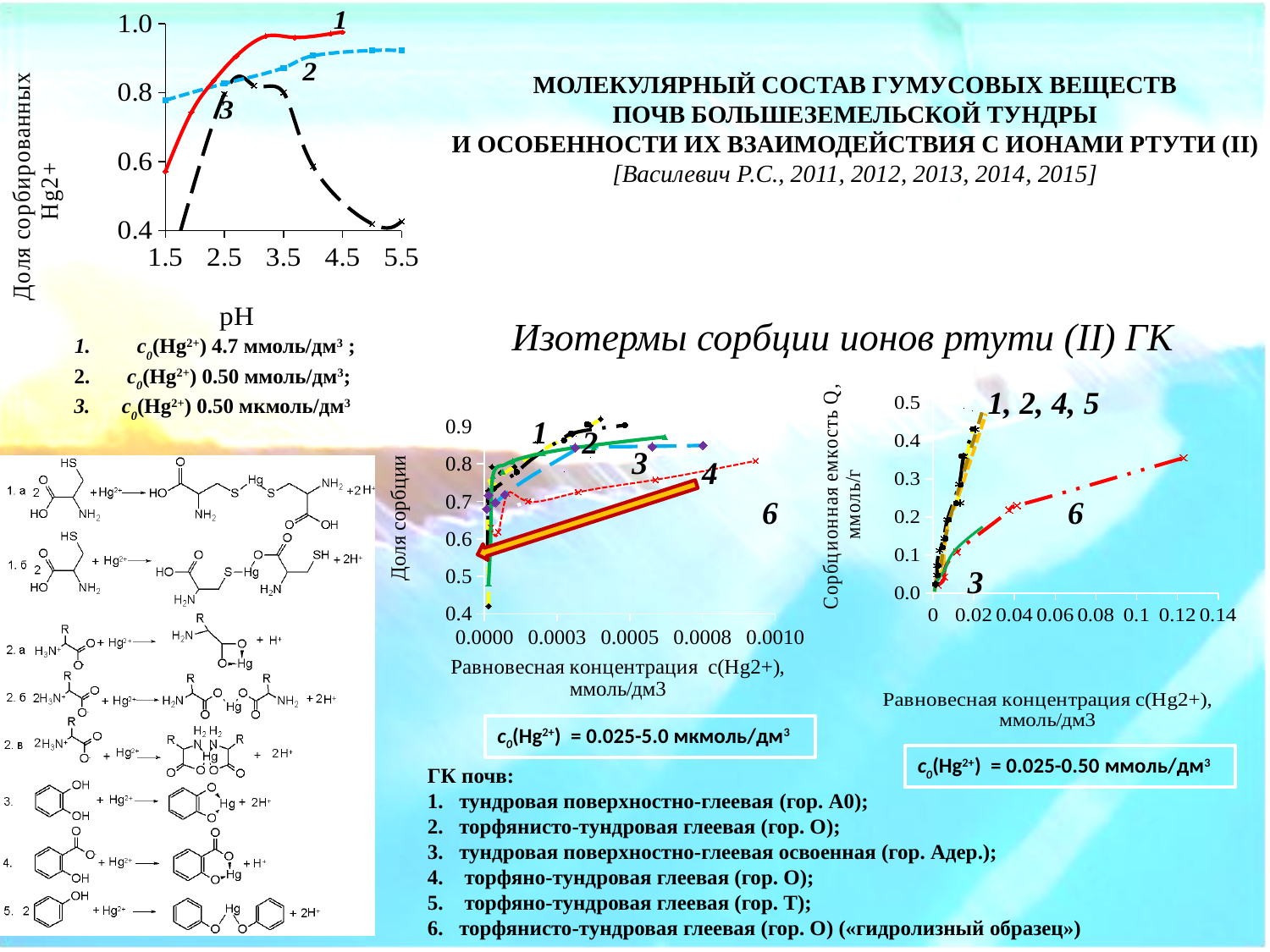
In the middle chart (Доля сорбции vs equilibrium concentration), is the value of curve 4 at a concentration of 0.0010 greater or less than 0.7? greater In the top-left chart (fraction of sorbed Hg2+ vs pH), is the value of curve 3 at pH 5.5 greater or less than 0.6? less In the top-left chart (fraction of sorbed Hg2+ vs pH), which curve is higher at pH 5.5: curve 2 or curve 3? curve 2 In the top-left chart (fraction of sorbed Hg2+ vs pH), is the value of curve 1 at pH 4.5 greater or less than 0.8? greater In the top-left chart (fraction of sorbed Hg2+ vs pH), does curve 1 rise or fall as pH increases from 1.5 to 4.5? rises What is the title shown above the two isotherm charts on the right half of the slide? Изотермы сорбции ионов ртути (II) ГК In the top-left chart (fraction of sorbed Hg2+ vs pH), how many curves are plotted? 3 What is the label of the x axis of the top-left chart? pH What kind of chart is the top-left chart plotting the fraction of sorbed Hg2+ against pH? line chart In the right chart (Сорбционная емкость Q vs equilibrium concentration), how many numbered curves are plotted? 6